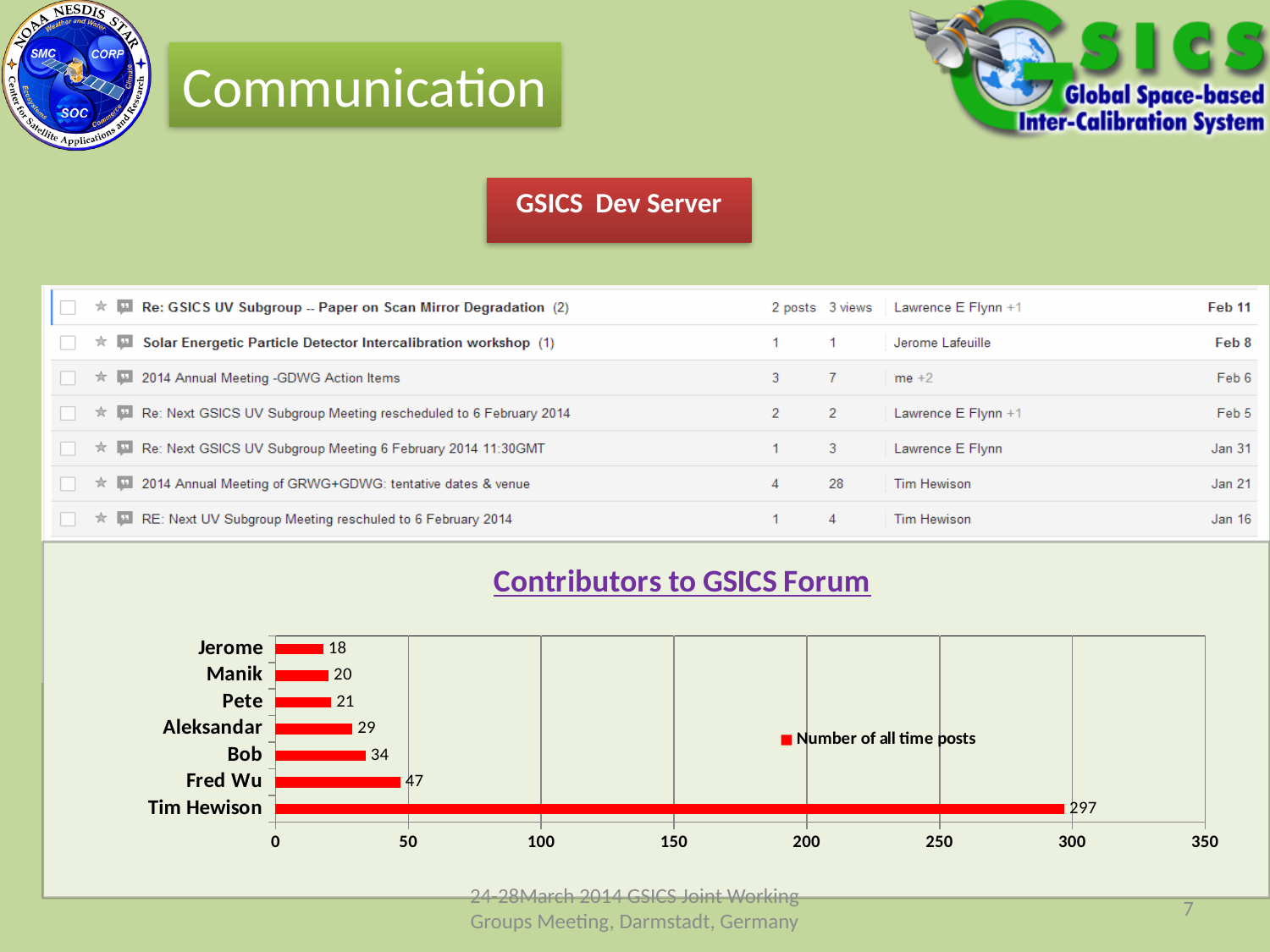
Which contributor has the highest number of all time posts? Tim Hewison Is the value for Fred Wu greater or less than 50? less What is the difference in all time posts between Tim Hewison and Fred Wu? 250 How many contributors are shown in the chart? 7 Which contributor has the lowest number of all time posts? Jerome What is the number of all time posts for Aleksandar? 29 What is the difference in all time posts between Bob and Pete? 13 What is the title of the chart? Contributors to GSICS Forum Who has more all time posts, Manik or Aleksandar? Aleksandar What is the number of all time posts for Fred Wu? 47 What is the number of all time posts for Tim Hewison? 297 What type of chart is used to show the contributors to the GSICS Forum? bar chart